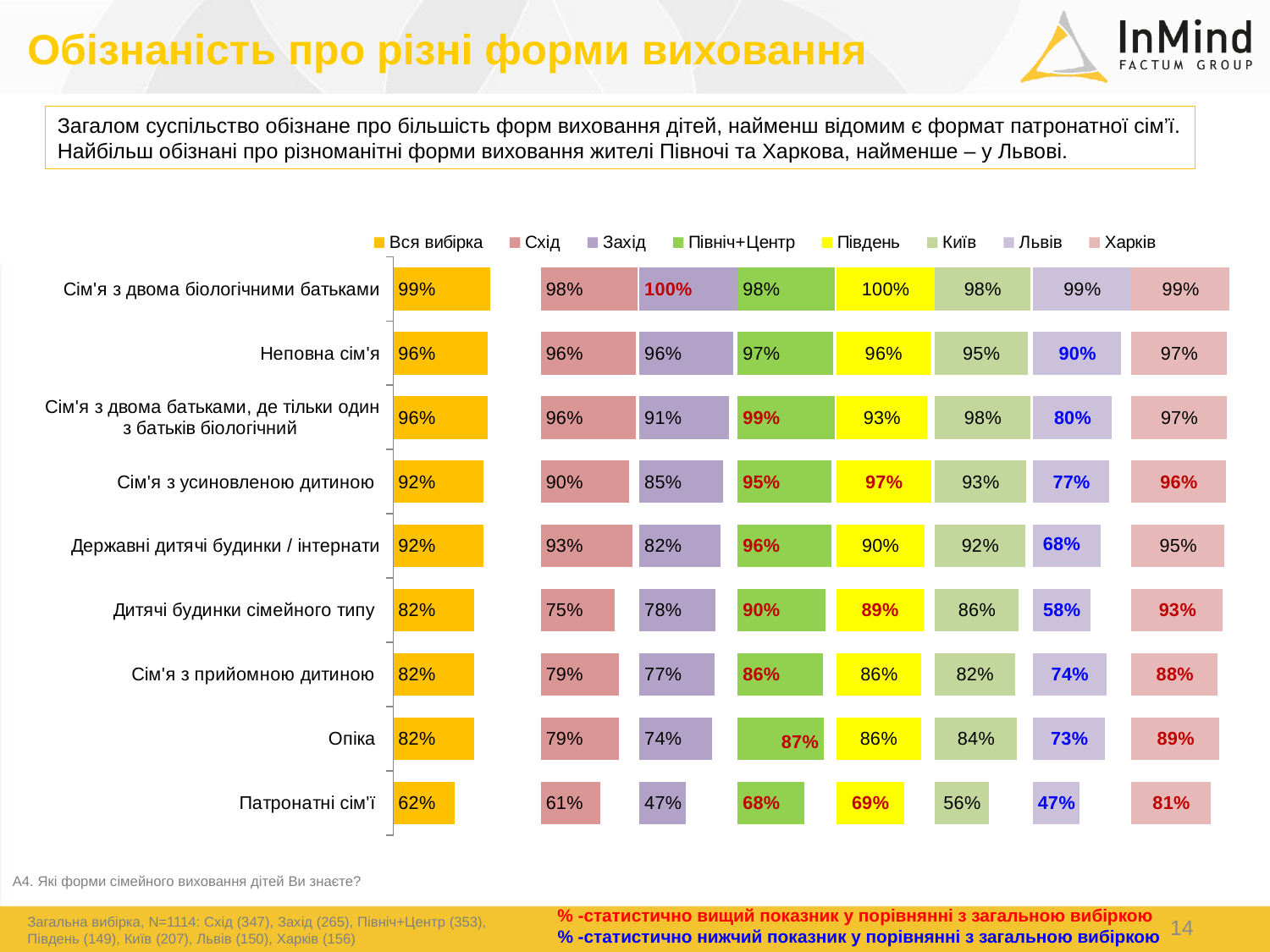
What is the value for "Сім'я з усиновленою дитиною" in the "Південь" series? 97% Which category has the highest value in the "Вся вибірка" series? Сім'я з двома біологічними батьками What is the value for "Патронатні сім'ї" in the "Вся вибірка" series? 62% Which region series has the highest value for "Патронатні сім'ї"? Харків What is the difference between the "Харків" and "Львів" values for "Патронатні сім'ї"? 34% What is the difference between the "Вся вибірка" values for "Сім'я з двома біологічними батьками" and "Патронатні сім'ї"? 37% Which is larger for "Опіка": the "Схід" value or the "Захід" value? Схід What kind of chart is shown on the slide? Bar chart How many series does the legend list? 8 How many categories (forms of upbringing) are shown on the chart? 9 Which category has the lowest value in the "Вся вибірка" series? Патронатні сім'ї What is the value for "Дитячі будинки сімейного типу" in the "Львів" series? 58%